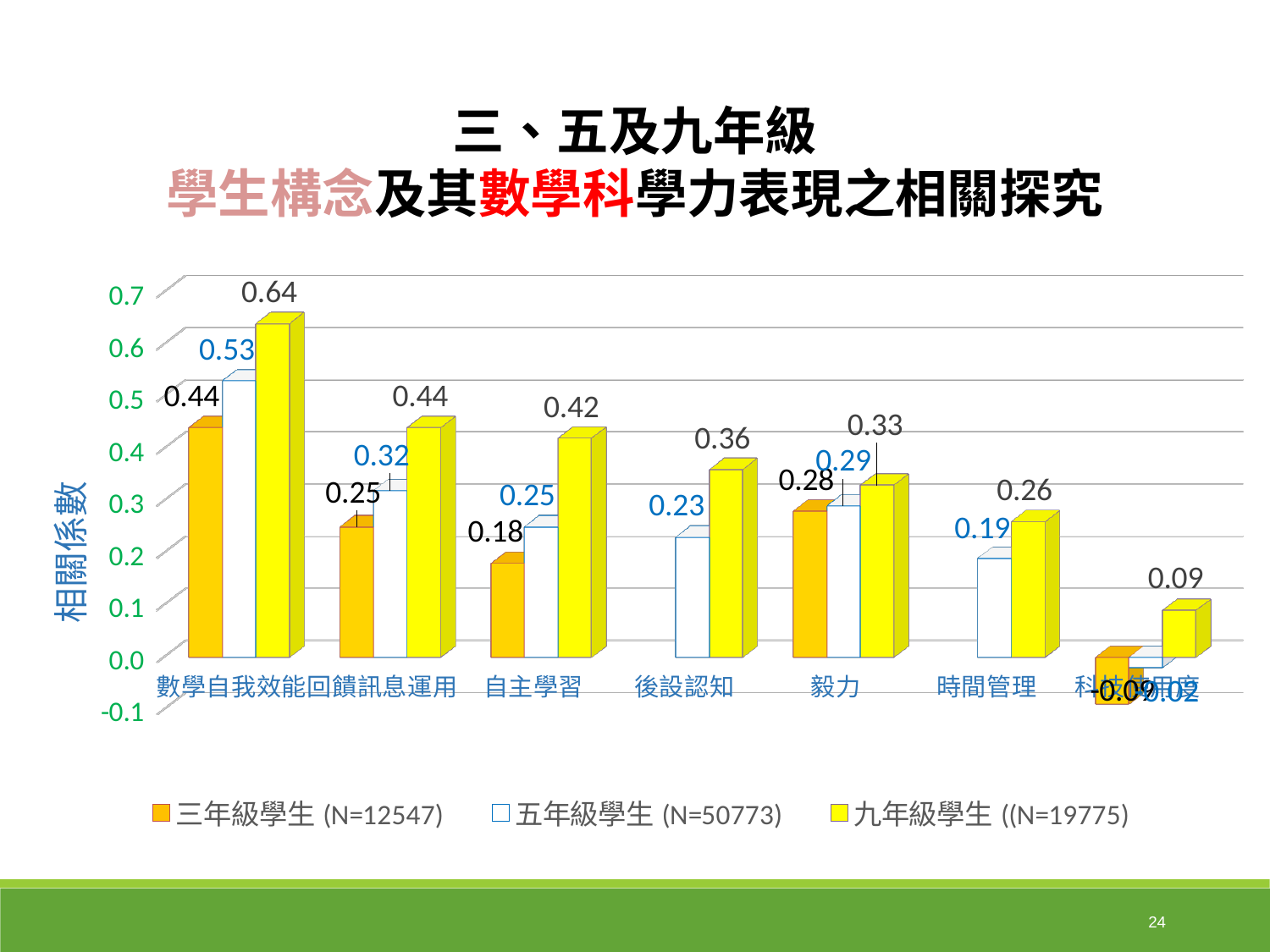
Is the value for 九年級學生 in the 後設認知 category greater or less than 0.3? greater What is the value for 三年級學生 in the 自主學習 category? 0.18 What is the correlation coefficient for 九年級學生 in the 數學自我效能 category? 0.64 What is the value for 五年級學生 in the 回饋訊息運用 category? 0.32 Which category has the highest value for 九年級學生? 數學自我效能 What is the title of the vertical axis? 相關係數 Do the 九年級學生 values generally rise or fall from left to right across the categories? fall What is the difference between the 九年級學生 and 三年級學生 values in the 數學自我效能 category? 0.2 How many series does the legend list? 3 Which is larger: the 九年級學生 value for 回饋訊息運用 or for 自主學習? 回饋訊息運用 What is the value for 九年級學生 in the 時間管理 category? 0.26 What kind of chart is shown on the slide? bar chart